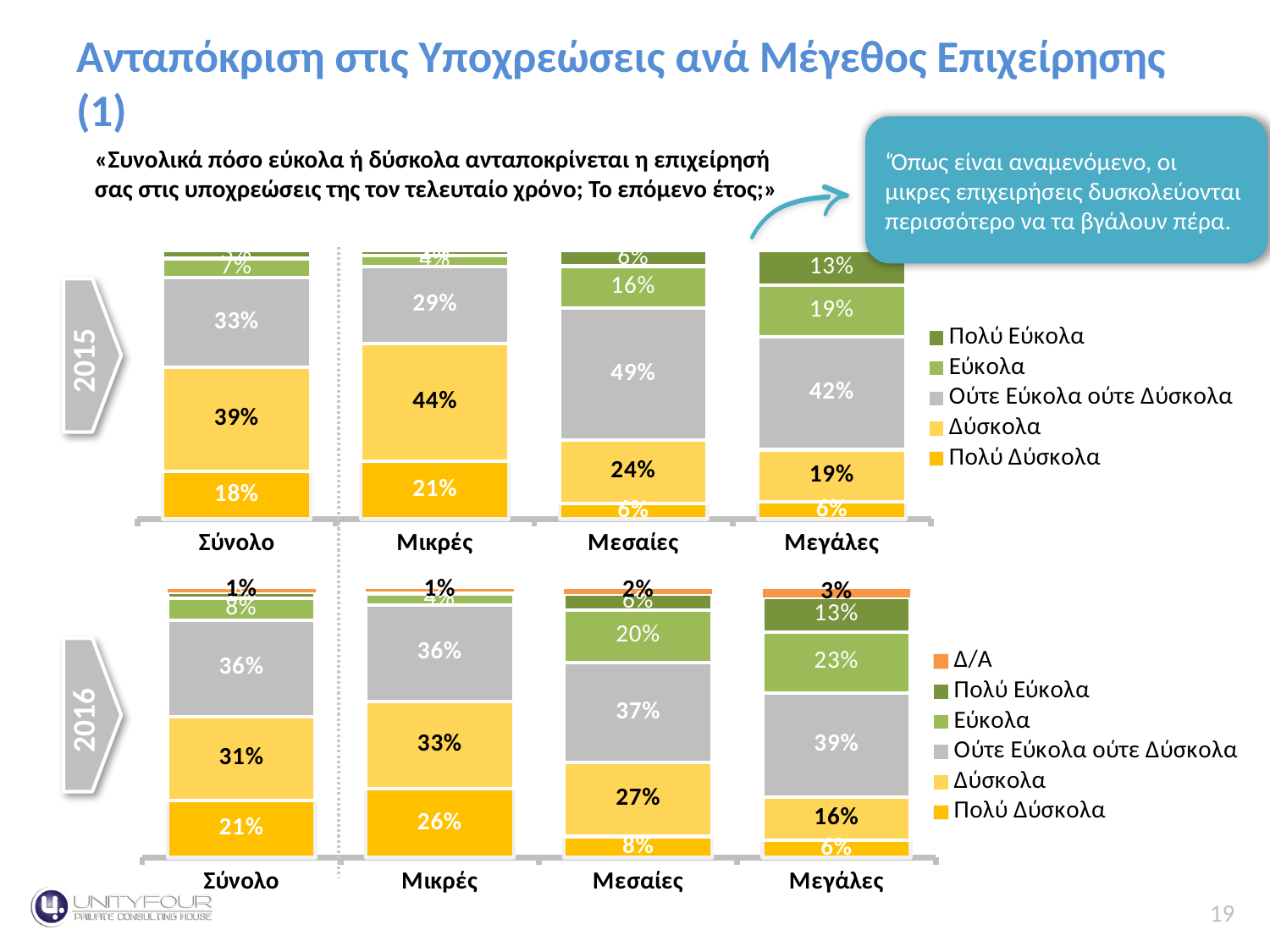
In the 2016 chart, which category has the lowest Δύσκολα value? Μεγάλες What type of chart is used for the 2015 data? Stacked bar chart In the 2015 chart, what is the value of Πολύ Εύκολα for Μεγάλες? 13% In the 2016 chart, what is the value of Πολύ Δύσκολα for Μικρές? 26% In the 2015 chart, what is the value of Δύσκολα for Μικρές? 44% In the 2015 chart, which is larger: Εύκολα for Μεσαίες or Εύκολα for Μεγάλες? Μεγάλες In the 2016 chart, what is the value of Δ/Α for Μεγάλες? 3% How many series does the legend of the 2016 chart list? 6 In the 2016 chart, what is the difference between the Δύσκολα values for Μικρές and Μεγάλες? 17% How many categories are shown on the x axis of the 2016 chart? 4 In the 2015 chart, which category has the highest Πολύ Δύσκολα value? Μικρές In the 2015 chart, what is the value of Ούτε Εύκολα ούτε Δύσκολα for Μεσαίες? 49%